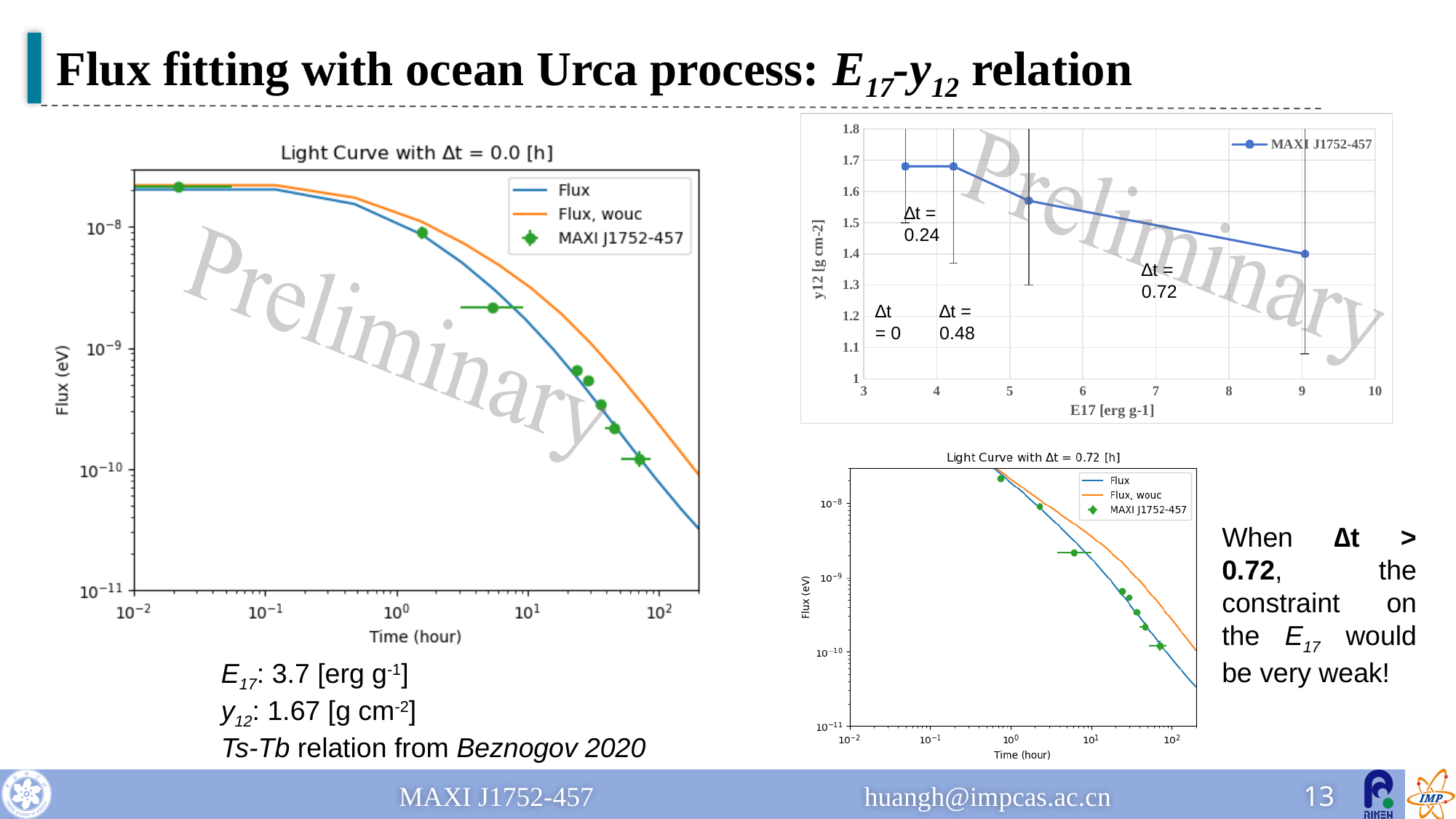
In the top-right E17-y12 chart, is the y12 value of the point labelled Δt = 0.72 greater or less than 1.5? less In the top-right E17-y12 chart, is the E17 value of the point labelled Δt = 0.72 greater or less than 8? greater What is the x-axis label of the top-right E17-y12 chart? E17 [erg g-1] In the top-right E17-y12 chart, is the y12 value of the point labelled Δt = 0 greater or less than 1.6? greater How many entries does the legend of the chart titled 'Light Curve with Δt = 0.0 [h]' list? 3 In the chart titled 'Light Curve with Δt = 0.0 [h]', does the flux rise or fall as time increases? fall What kind of chart is the top-right chart showing y12 against E17? line chart How many series does the legend of the top-right E17-y12 chart list? 1 In the top-right E17-y12 chart, which point has the lowest y12 value: Δt = 0 or Δt = 0.72? Δt = 0.72 In the chart titled 'Light Curve with Δt = 0.72 [h]', which curve is higher at 10^2 hours: 'Flux' or 'Flux, wouc'? Flux, wouc In the top-right E17-y12 chart, how many data points are plotted for MAXI J1752-457? 4 In the top-right E17-y12 chart, does y12 rise or fall as E17 increases? fall